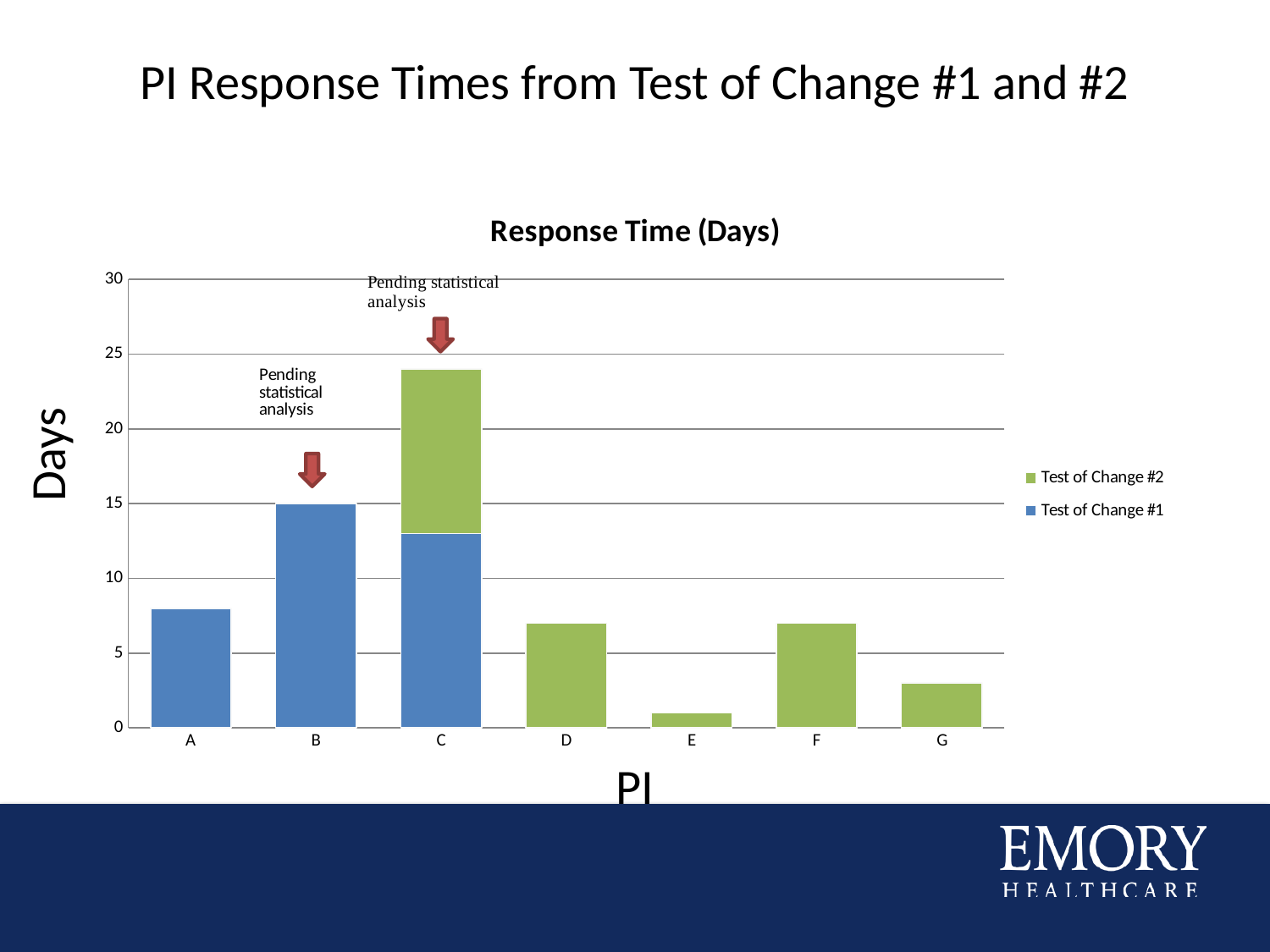
What is the Test of Change #1 response time for PI B? 15 Is the total stacked value for PI C greater or less than 20? greater How many PI categories are shown on the x axis of the chart? 7 Is the value for PI G greater or less than 5? less Which PI has the tallest total bar? C What is the title of the chart? Response Time (Days) What type of chart is shown on the slide? Stacked bar chart How many series does the legend list? 2 Is the value for PI A greater or less than 10? less Which PI has the shortest bar? E Which is larger, the bar for PI D or the bar for PI G? D Which series is shown in green in the legend? Test of Change #2